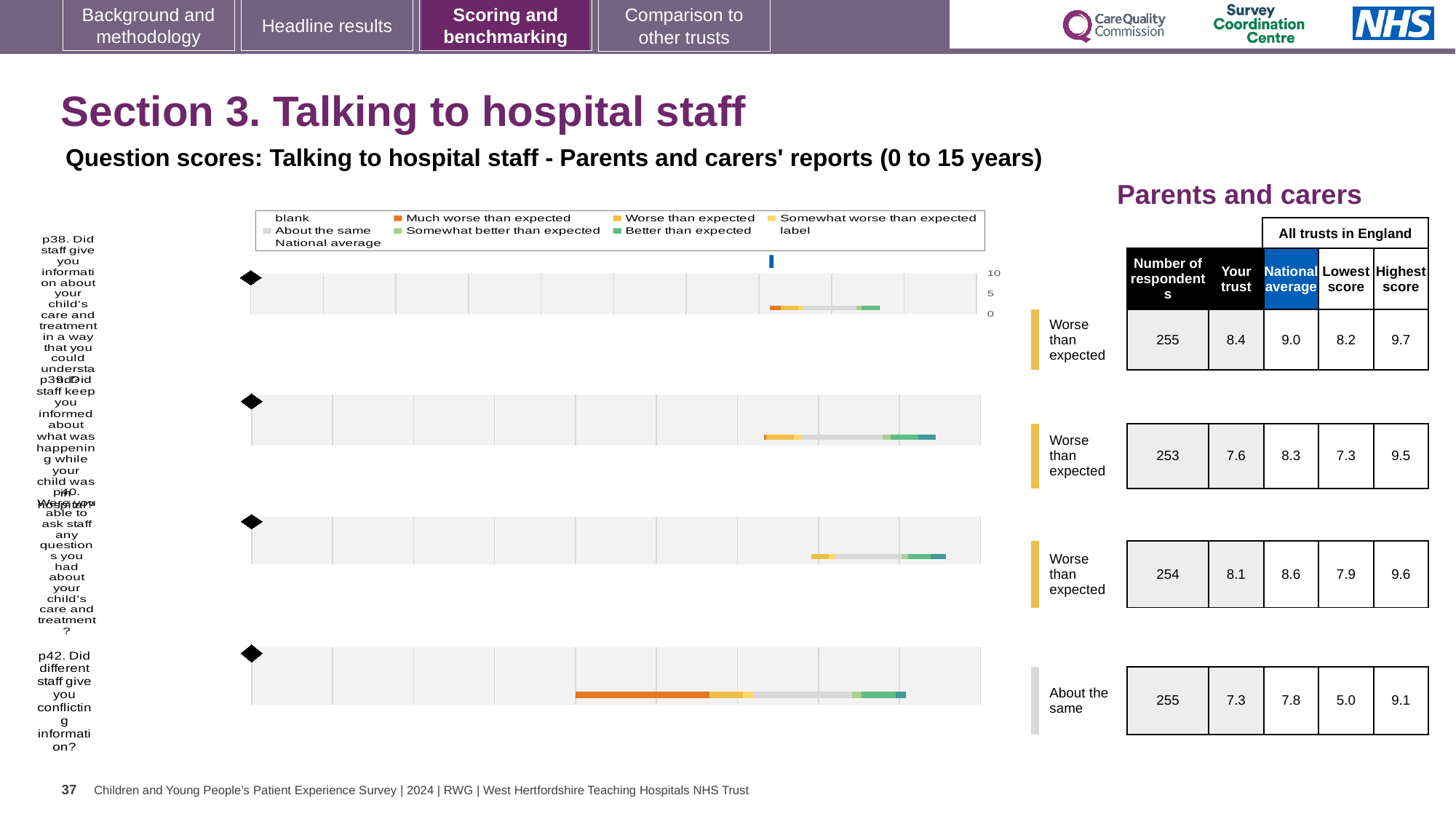
For question p39 (Did staff keep you informed about what was happening while your child was in hospital?), what is the National average score? 8.3 Which of the four questions has the lowest 'Your trust' score? p42 Which of the four questions has the highest 'Your trust' score? p38 For question p38, what is the difference between the National average score and the 'Your trust' score? 0.6 For question p40 (Were you able to ask staff any questions you had about your child's care and treatment?), what is the Highest score among all trusts in England? 9.6 For question p42 (Did different staff give you conflicting information?), what is the Lowest score among all trusts in England? 5.0 What kind of chart is used to show each question's score? Bar chart For question p40, which is larger: the 'Your trust' score or the National average score? National average What benchmark category is shown for question p42? About the same How many respondents are shown for question p40? 254 For question p38 (Did staff give you information about your child's care and treatment in a way that you could understand?), what is the 'Your trust' score shown? 8.4 How many question charts are shown on the slide? 4